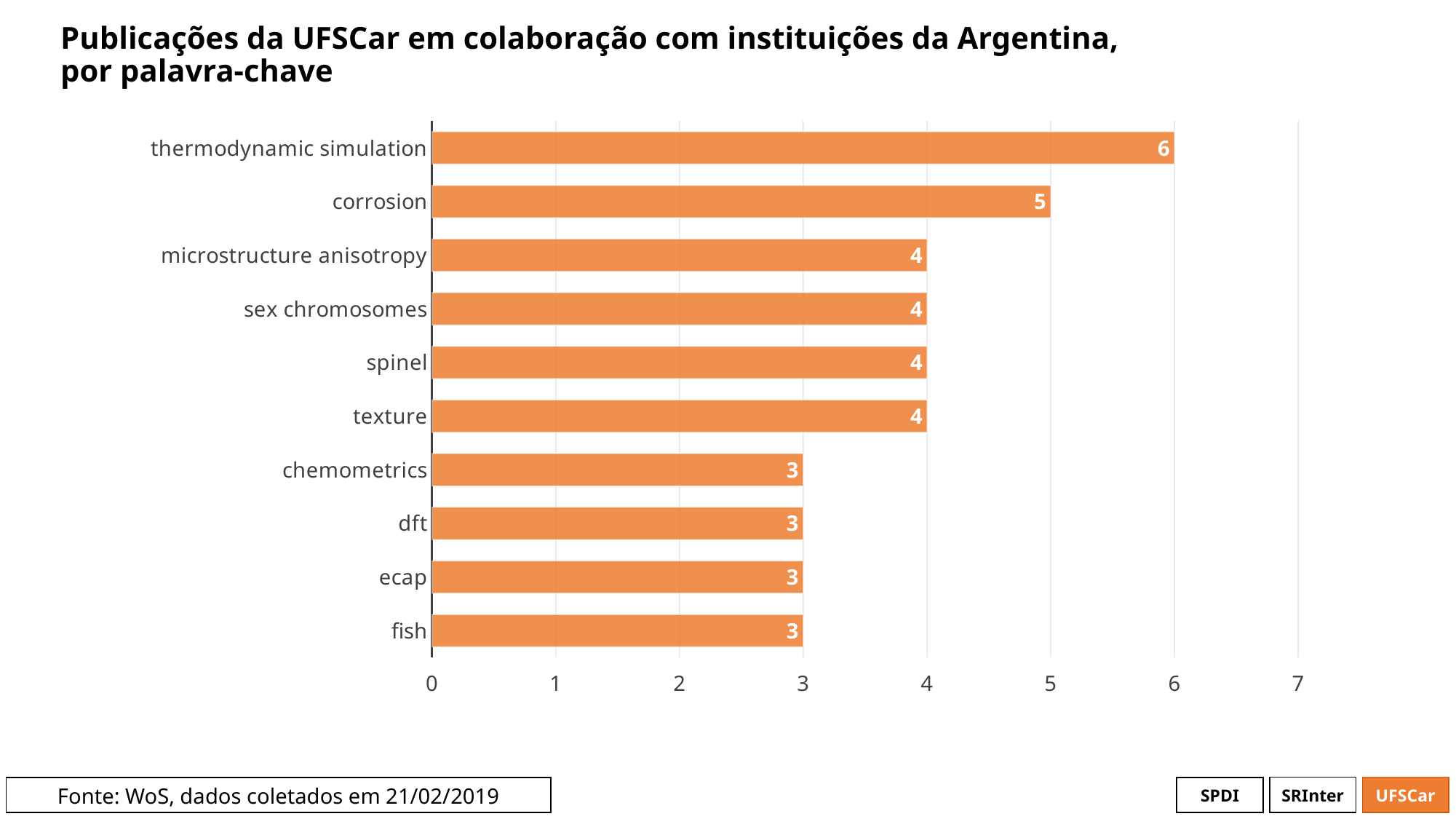
What is the value for sex chromosomes? 4 How many keywords have a value of 4? 4 Which keyword has the highest value? thermodynamic simulation How many keywords are shown in the chart? 10 What is the difference between the values for thermodynamic simulation and corrosion? 1 What is the value for corrosion? 5 What is the value for chemometrics? 3 What is the data source stated at the bottom of the slide? WoS, dados coletados em 21/02/2019 Which is larger, the value for spinel or the value for dft? spinel What is the difference between the values for corrosion and fish? 2 What is the value for thermodynamic simulation? 6 What kind of chart is shown on the slide? bar chart